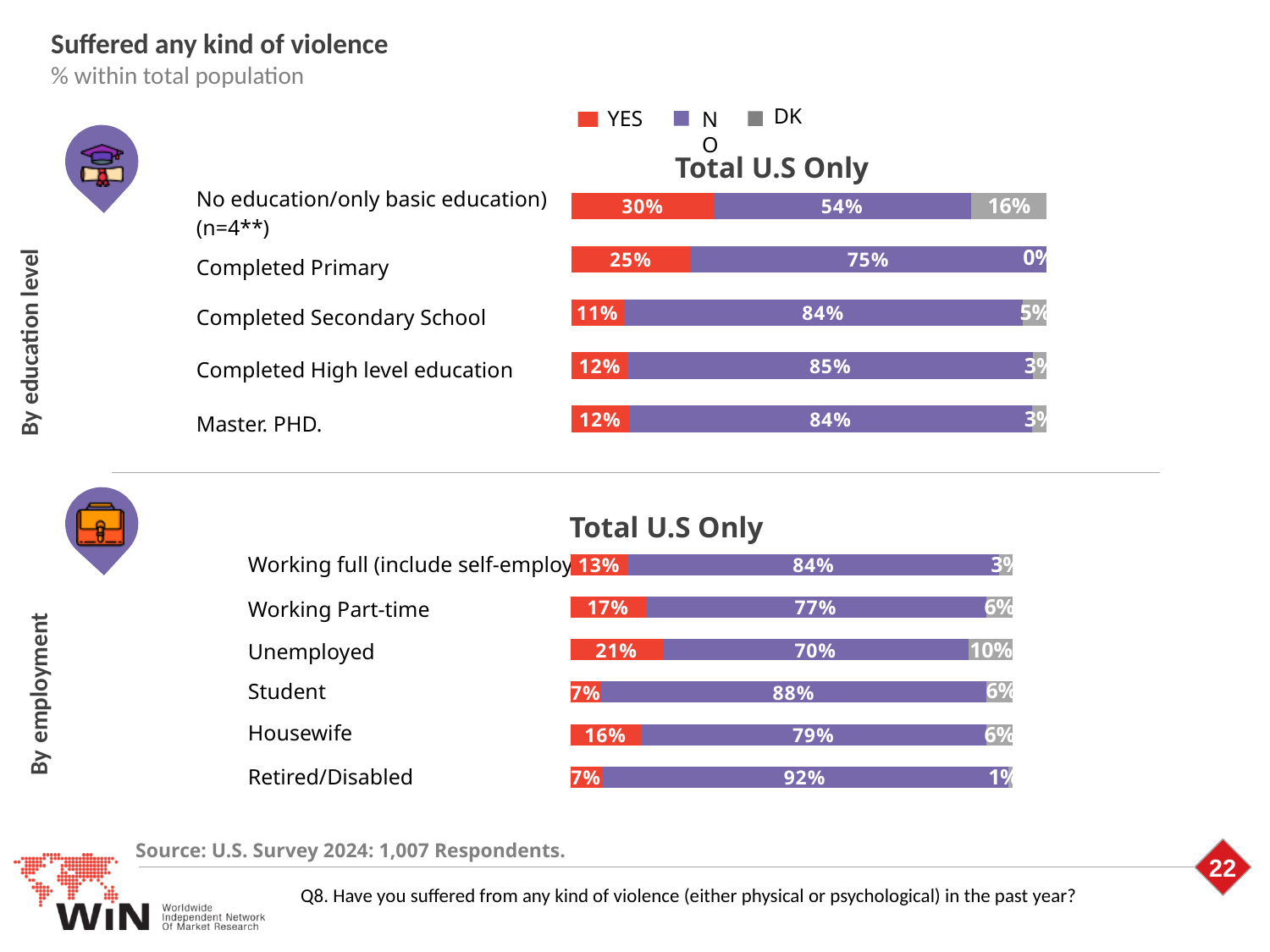
How many series does the legend list? 3 How many categories are shown in the 'By employment' chart? 6 In the 'By employment' chart, which category has the highest NO value? Retired/Disabled In the 'By education level' chart, which category has the lowest YES value? Completed Secondary School In the 'By education level' chart, what is the DK value for No education/only basic education? 16% In the 'By employment' chart, which category has the highest DK value? Unemployed In the 'By education level' chart, what is the YES value for Completed Primary? 25% In the 'By employment' chart, what is the NO value for Unemployed? 70% In the 'By education level' chart, which category has the highest YES value? No education/only basic education In the 'By employment' chart, what is the difference between the YES values for Unemployed and Student? 14% In the 'By education level' chart, what is the difference between the NO values for Completed Primary and No education/only basic education? 21% In the 'By employment' chart, is the YES value larger for Working Part-time or Housewife? Working Part-time